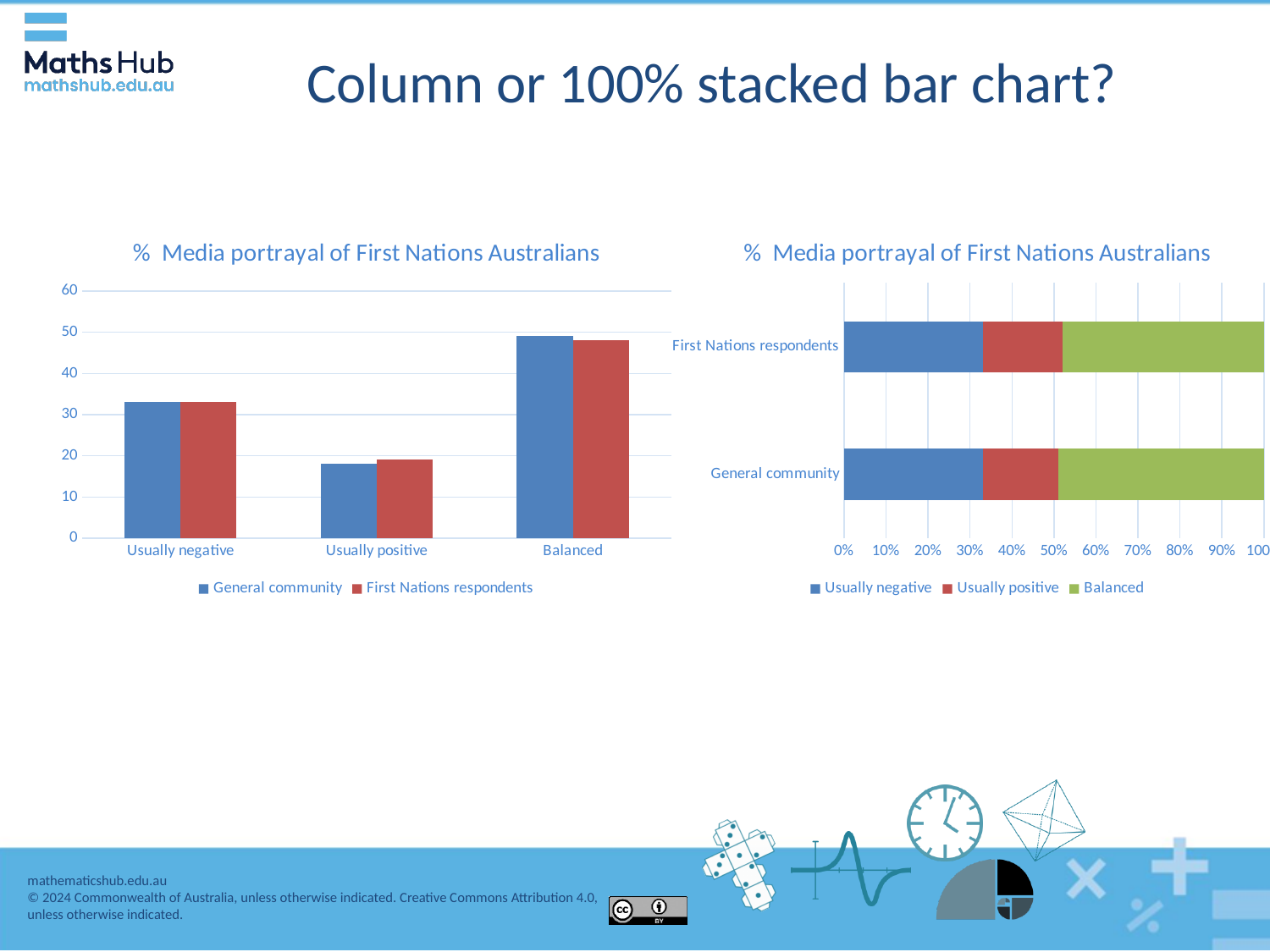
In the right chart, what colour represents the Balanced series? green How many categories are shown on the vertical axis of the right chart? 2 How many series does the legend of the right chart list? 3 How many categories are shown on the x axis of the left chart? 3 In the left chart, which is larger for First Nations respondents: Balanced or Usually positive? Balanced How many series does the legend of the left chart list? 2 In the left chart, which category has the lowest value for First Nations respondents? Usually positive What kind of chart is the chart on the left of the slide? bar chart In the left chart, is the General community value for Usually positive greater or less than 20? less In the left chart, is the First Nations respondents value for Usually negative greater or less than 30? greater In the left chart, is the General community value for Balanced greater or less than 40? greater In the left chart, which category has the highest value for General community? Balanced